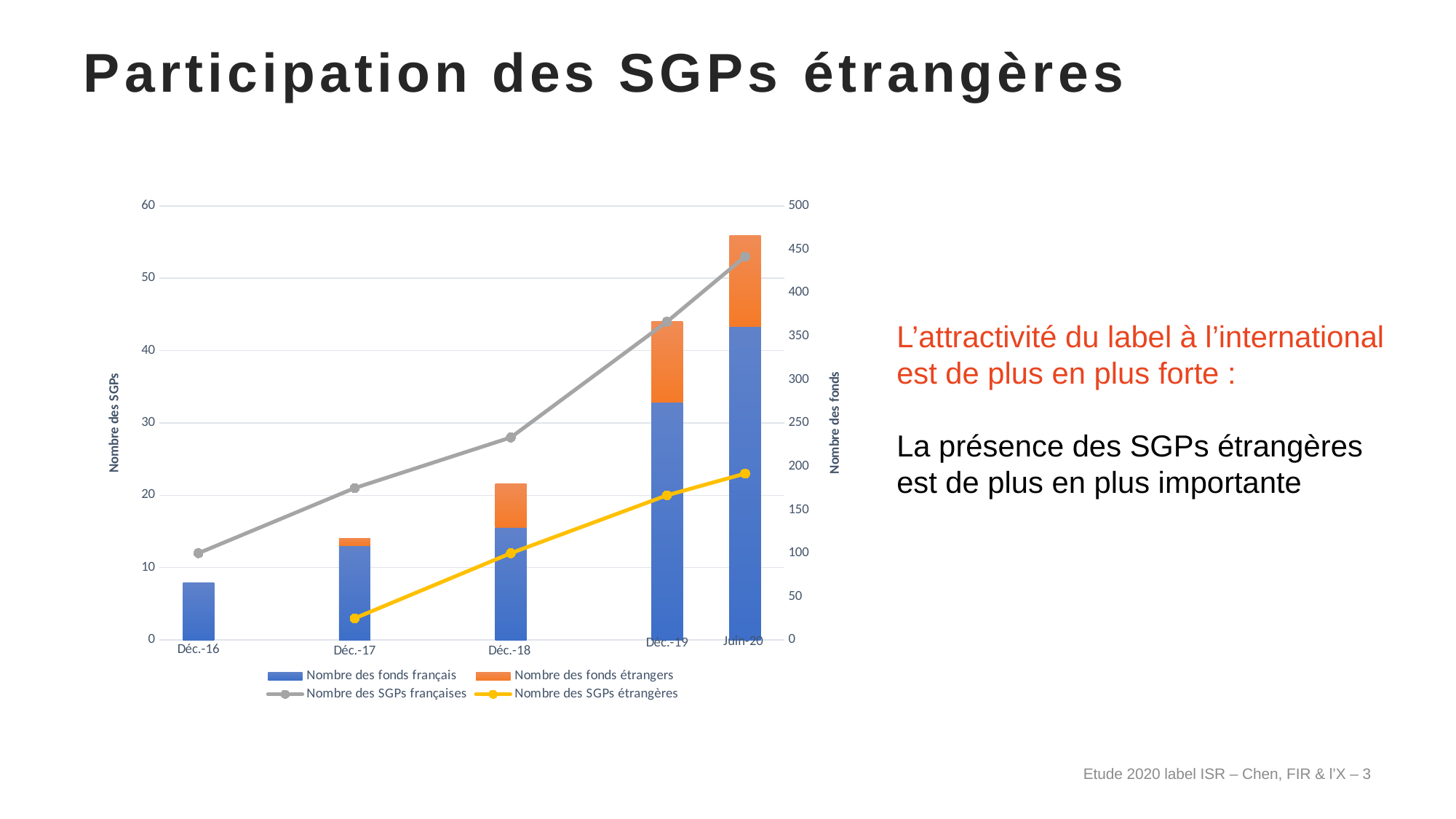
Does the 'Nombre des SGPs françaises' line rise or fall from Déc.-16 to Juin-20? rise Which is larger, the 'Nombre des fonds français' bar for Déc.-19 or for Déc.-18? Déc.-19 Which period has the tallest stacked bar? Juin-20 How many series does the chart legend list? 4 What colour represents 'Nombre des fonds étrangers' in the chart? Orange Is the total stacked bar for Juin-20 greater or less than 50 on the left axis? greater Is the 'Nombre des fonds français' bar for Déc.-16 greater or less than 10 on the left axis? less How many time periods are shown on the x axis of the chart? 5 What kind of chart is shown on the slide? A combined stacked bar and line chart Which period has the shortest stacked bar? Déc.-16 Is the 'Nombre des SGPs françaises' line value for Juin-20 greater or less than 400 on the right axis? greater